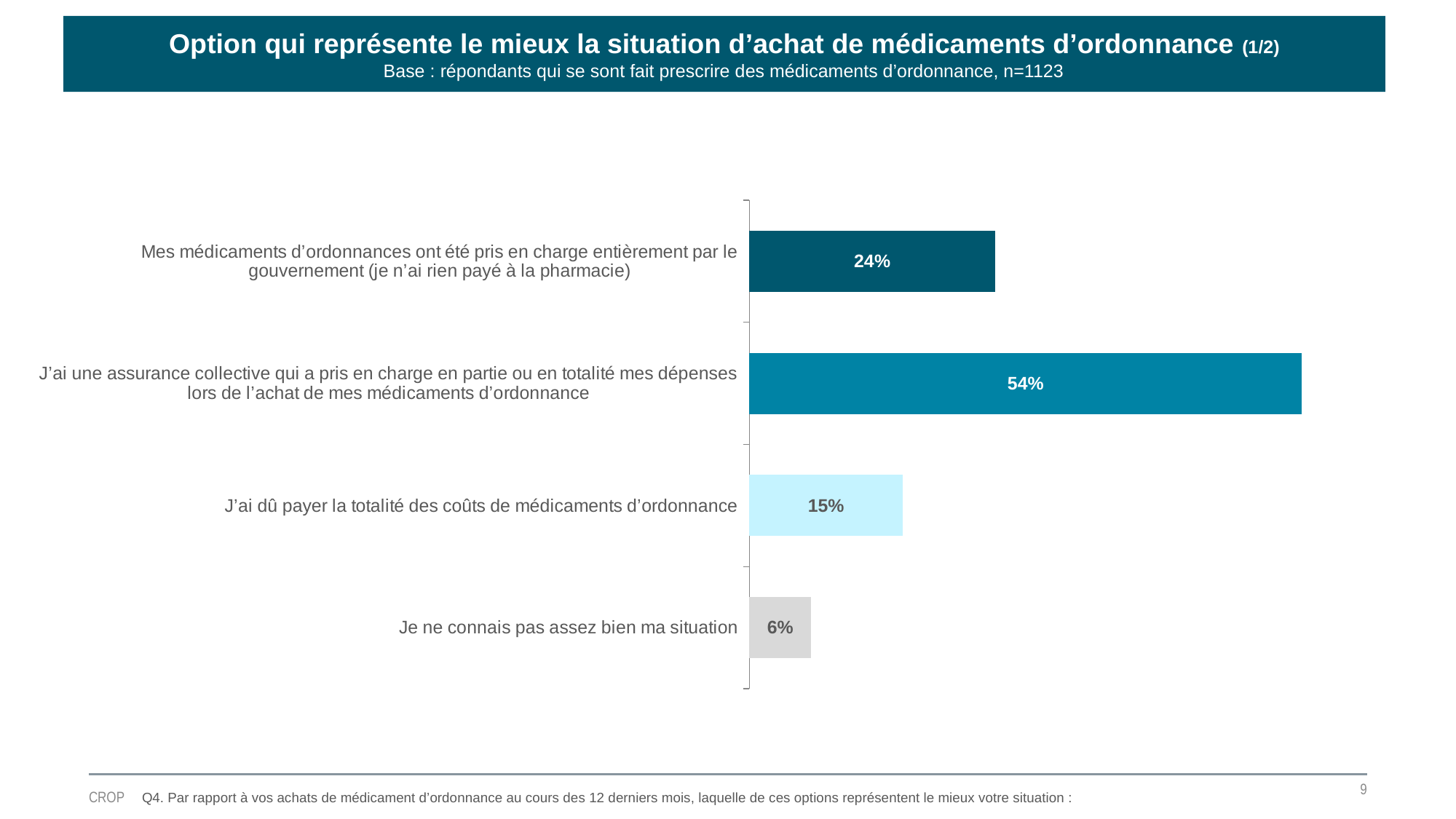
What type of chart is shown on the slide? Bar chart What is the difference in percentage points between those who paid the full cost and those who do not know their situation well enough? 9 What percentage of respondents said a group insurance plan covered part or all of their prescription drug expenses? 54% What percentage of respondents said their prescription drugs were fully covered by the government (paid nothing at the pharmacy)? 24% What is the difference in percentage points between the group insurance option and the government fully covered option? 30 What is the base size (n) of respondents indicated in the chart title? n=1123 What percentage of respondents said they do not know their situation well enough? 6% Which option has the lowest percentage of respondents? Je ne connais pas assez bien ma situation How many response options are shown in the chart? 4 What percentage of respondents said they had to pay the full cost of their prescription drugs? 15% Which is larger: the share whose drugs were fully covered by the government, or the share who had to pay the full cost? Fully covered by the government (24%) Which option has the highest percentage of respondents? J'ai une assurance collective qui a pris en charge en partie ou en totalité mes dépenses lors de l'achat de mes médicaments d'ordonnance